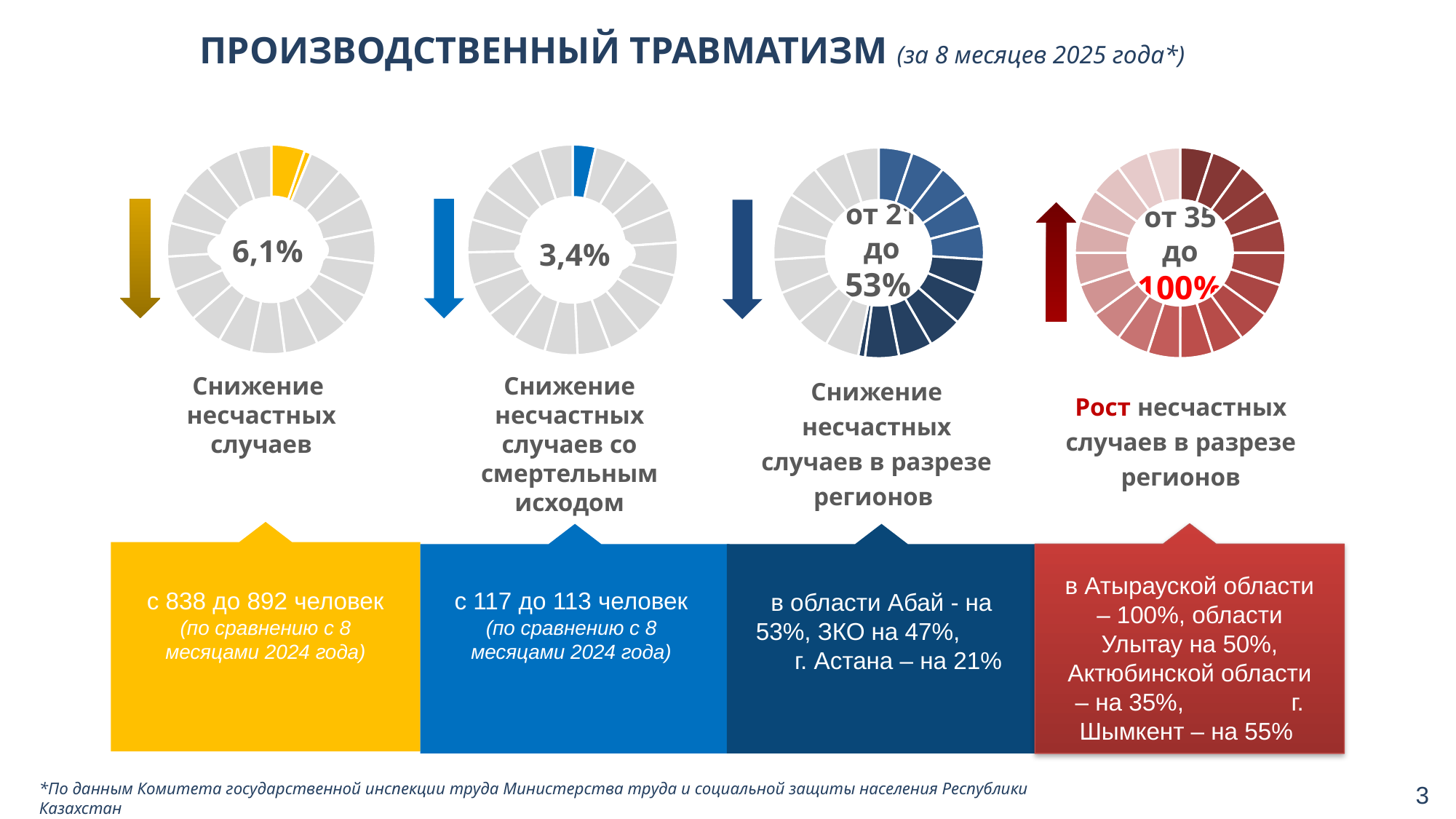
What range is shown in the centre of the third donut chart (Снижение несчастных случаев в разрезе регионов)? от 21 до 53% What colour is the highlighted segment in the leftmost donut chart? Yellow What range is shown in the centre of the rightmost donut chart (Рост несчастных случаев в разрезе регионов)? от 35 до 100% According to the text under the rightmost donut chart, which region had the highest growth in accidents? Атырауская область (100%) What value is shown in the centre of the second donut chart (Снижение несчастных случаев со смертельным исходом)? 3,4% What is the difference between the value in the first donut chart (6,1%) and the value in the second donut chart (3,4%)? 2,7 percentage points How many donut charts are on the slide? 4 Which donut chart is accompanied by an upward arrow? The rightmost one (Рост несчастных случаев в разрезе регионов) What value is shown in the centre of the leftmost donut chart (Снижение несчастных случаев)? 6,1% According to the text under the second donut chart, from what number to what number did fatal accidents decrease? с 117 до 113 человек Which is larger: the value in the first donut chart (6,1%) or the value in the second donut chart (3,4%)? The first donut chart (6,1%) What kind of charts are shown on the slide? Donut charts